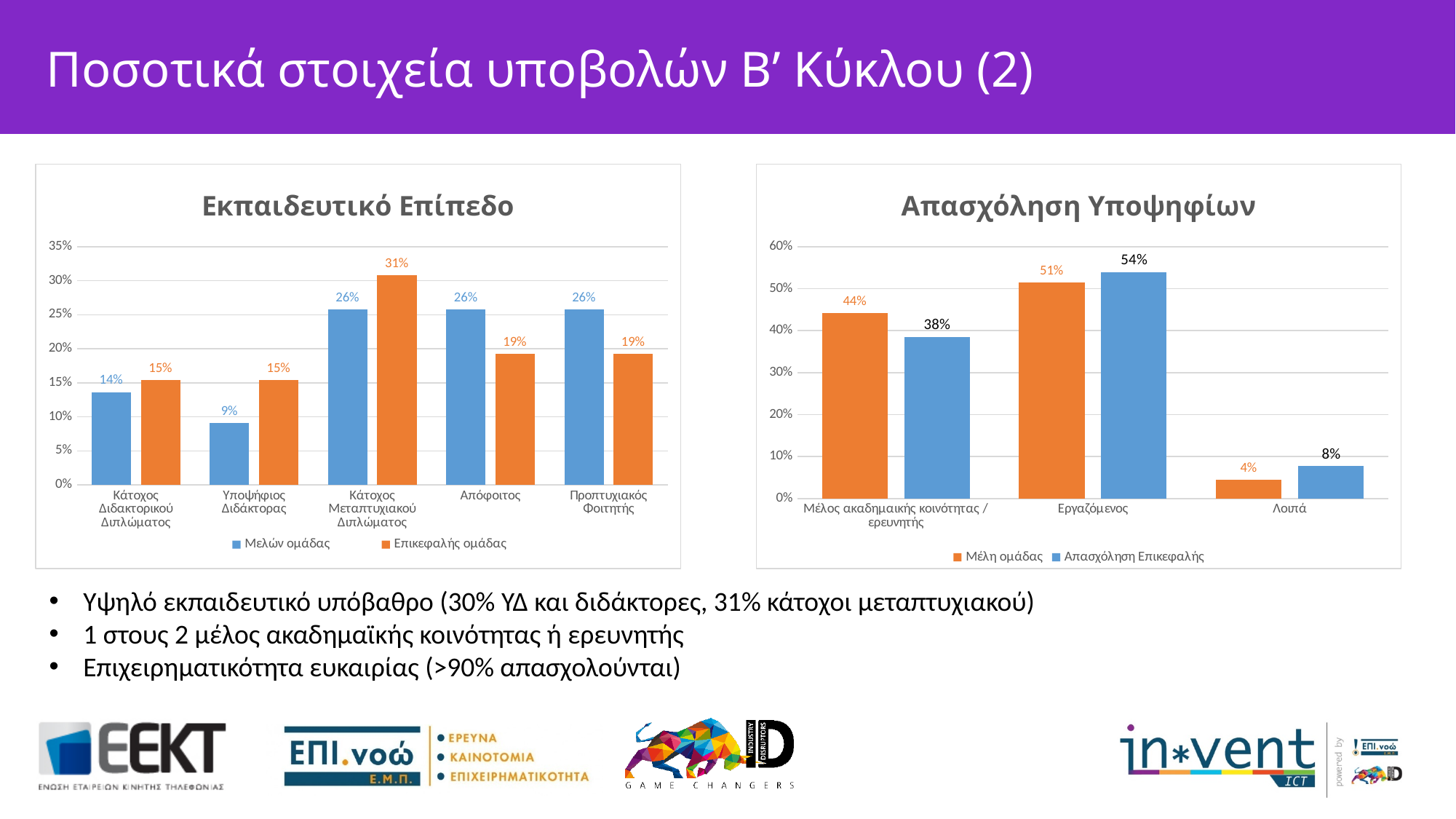
In the chart titled 'Απασχόληση Υποψηφίων', what is the value of 'Μέλη ομάδας' for 'Λοιπά'? 4% In the chart titled 'Εκπαιδευτικό Επίπεδο', which category has the highest value for 'Επικεφαλής ομάδας'? Κάτοχος Μεταπτυχιακού Διπλώματος In the chart titled 'Εκπαιδευτικό Επίπεδο', which category has the lowest value for 'Μελών ομάδας'? Υποψήφιος Διδάκτορας In the chart titled 'Εκπαιδευτικό Επίπεδο', what is the value of 'Μελών ομάδας' for 'Υποψήφιος Διδάκτορας'? 9% In the chart titled 'Εκπαιδευτικό Επίπεδο', what is the difference between 'Μελών ομάδας' and 'Επικεφαλής ομάδας' for 'Απόφοιτος'? 7% In the chart titled 'Απασχόληση Υποψηφίων', which is larger for 'Μέλος ακαδημαϊκής κοινότητας / ερευνητής': 'Μέλη ομάδας' or 'Απασχόληση Επικεφαλής'? Μέλη ομάδας In the chart titled 'Απασχόληση Υποψηφίων', what is the difference between 'Μέλη ομάδας' and 'Απασχόληση Επικεφαλής' for 'Μέλος ακαδημαϊκής κοινότητας / ερευνητής'? 6% What type of chart is the chart titled 'Απασχόληση Υποψηφίων'? Bar chart In the chart titled 'Εκπαιδευτικό Επίπεδο', how many categories are shown on the x axis? 5 In the chart titled 'Εκπαιδευτικό Επίπεδο', what is the value of 'Επικεφαλής ομάδας' for 'Κάτοχος Μεταπτυχιακού Διπλώματος'? 31% In the chart titled 'Απασχόληση Υποψηφίων', how many series does the legend list? 2 In the chart titled 'Απασχόληση Υποψηφίων', what is the value of 'Απασχόληση Επικεφαλής' for 'Εργαζόμενος'? 54%